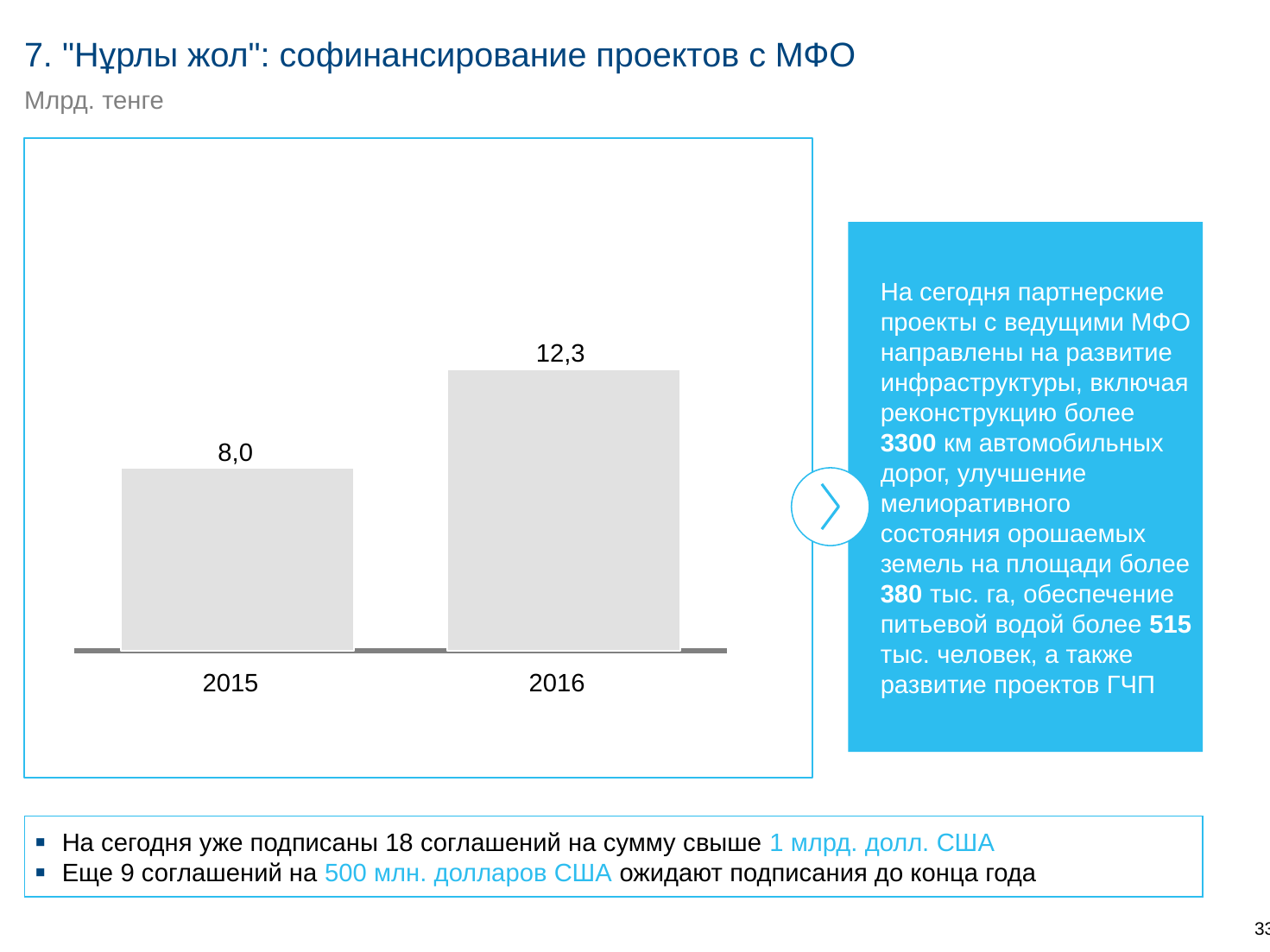
What is the total of the values for 2015 and 2016? 20,3 What is the value for 2016? 12,3 What unit is stated for the chart values? Млрд. тенге Which year has the highest value? 2016 What is the value for 2015? 8,0 Which year has the lowest value? 2015 Which is larger, the value for 2015 or the value for 2016? 2016 What kind of chart is shown on the slide? Bar chart How many categories are shown in the chart? 2 Do the values rise or fall from 2015 to 2016? Rise What is the difference between the values for 2016 and 2015? 4,3